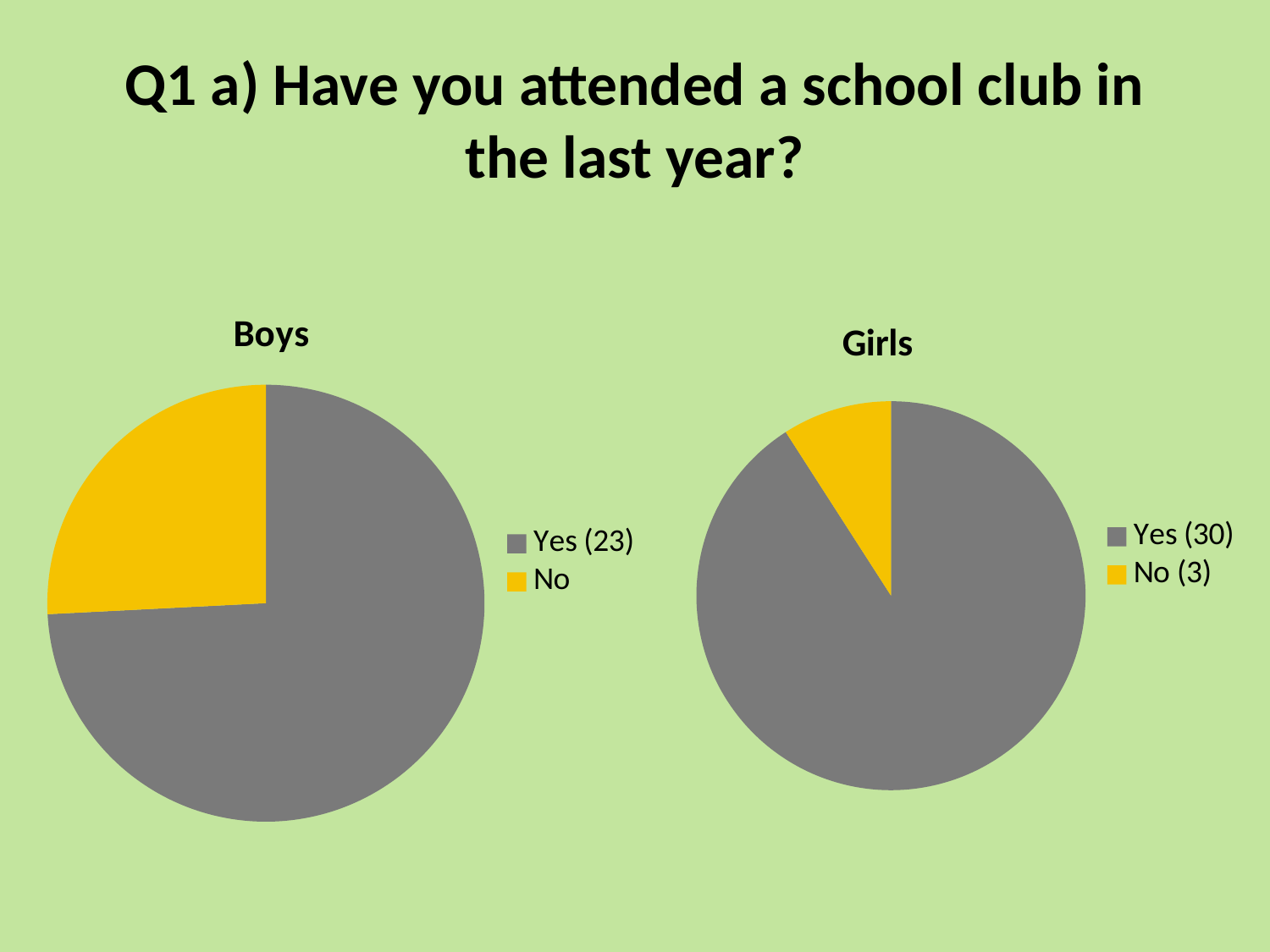
In the Girls pie chart, how many girls answered No? 3 In the Girls pie chart, what is the difference between the Yes and No counts? 27 Comparing the two charts, which group has more Yes responses, Boys or Girls? Girls In the Girls pie chart, how many girls answered Yes? 30 In the Girls pie chart, what is the total number of responses? 33 How many slices does the Boys pie chart have? 2 In the Girls pie chart, which category has the largest slice? Yes What type of chart is used for the Boys data? Pie chart In the Girls pie chart, which category has the smallest slice? No In the Boys pie chart, which slice is larger, Yes or No? Yes In the Boys pie chart, how many boys answered Yes? 23 In the Girls pie chart, what colour is the No slice? Yellow